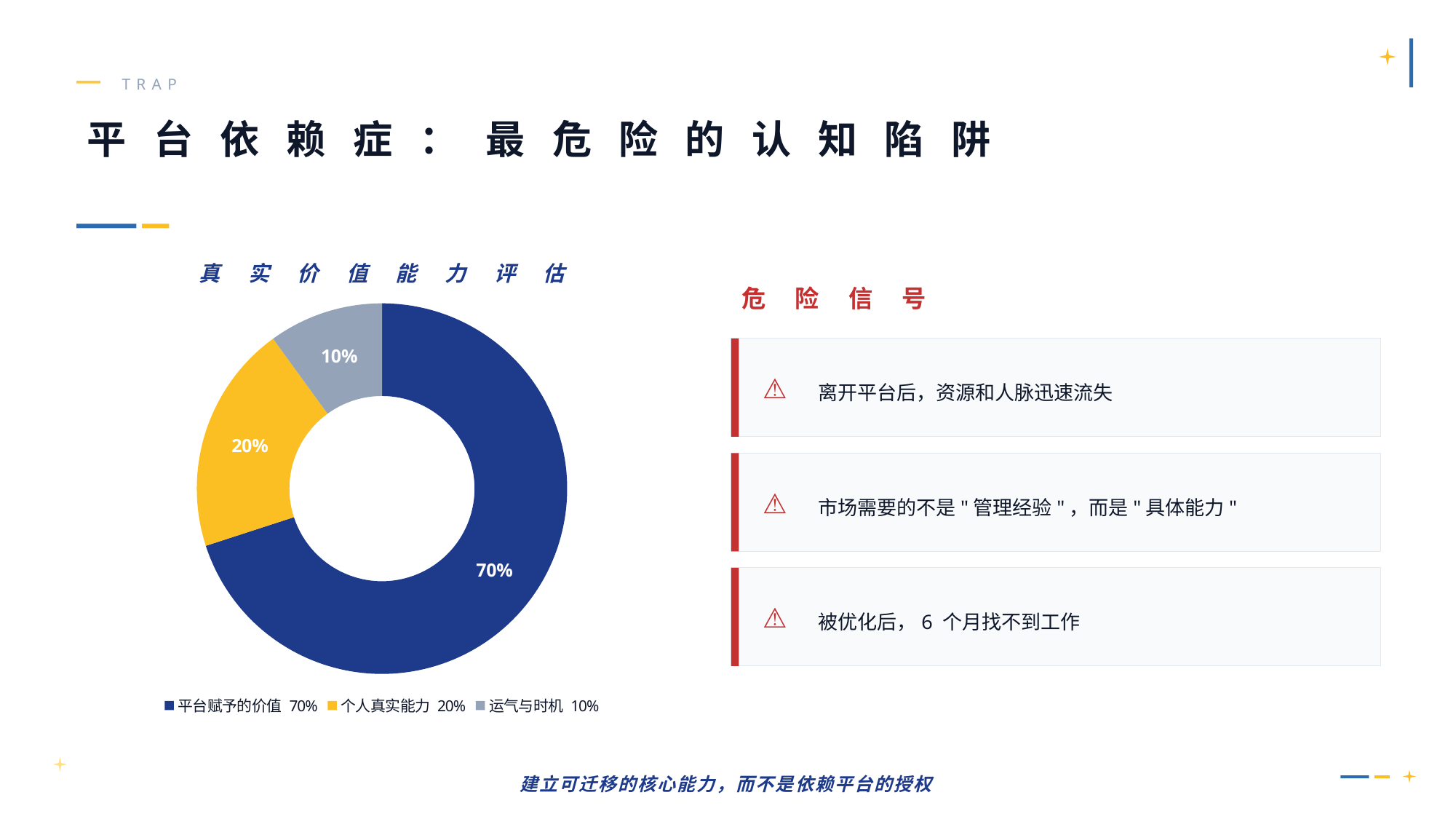
What kind of chart is shown under the title 真实价值能力评估? Doughnut (pie) chart How many categories does the chart show? 3 What colour is the slice for 个人真实能力? Yellow What is the value for 运气与时机 in the chart? 10% What is the value for 个人真实能力 in the chart? 20% What is the title of the chart? 真实价值能力评估 What is the value for 平台赋予的价值 in the chart? 70% Which is larger, the share of 个人真实能力 or the share of 运气与时机? 个人真实能力 Which category has the smallest share in the chart? 运气与时机 What is the difference between the shares of 平台赋予的价值 and 个人真实能力? 50% Which category has the largest share in the chart? 平台赋予的价值 What share of the chart does 运气与时机 represent? 10%